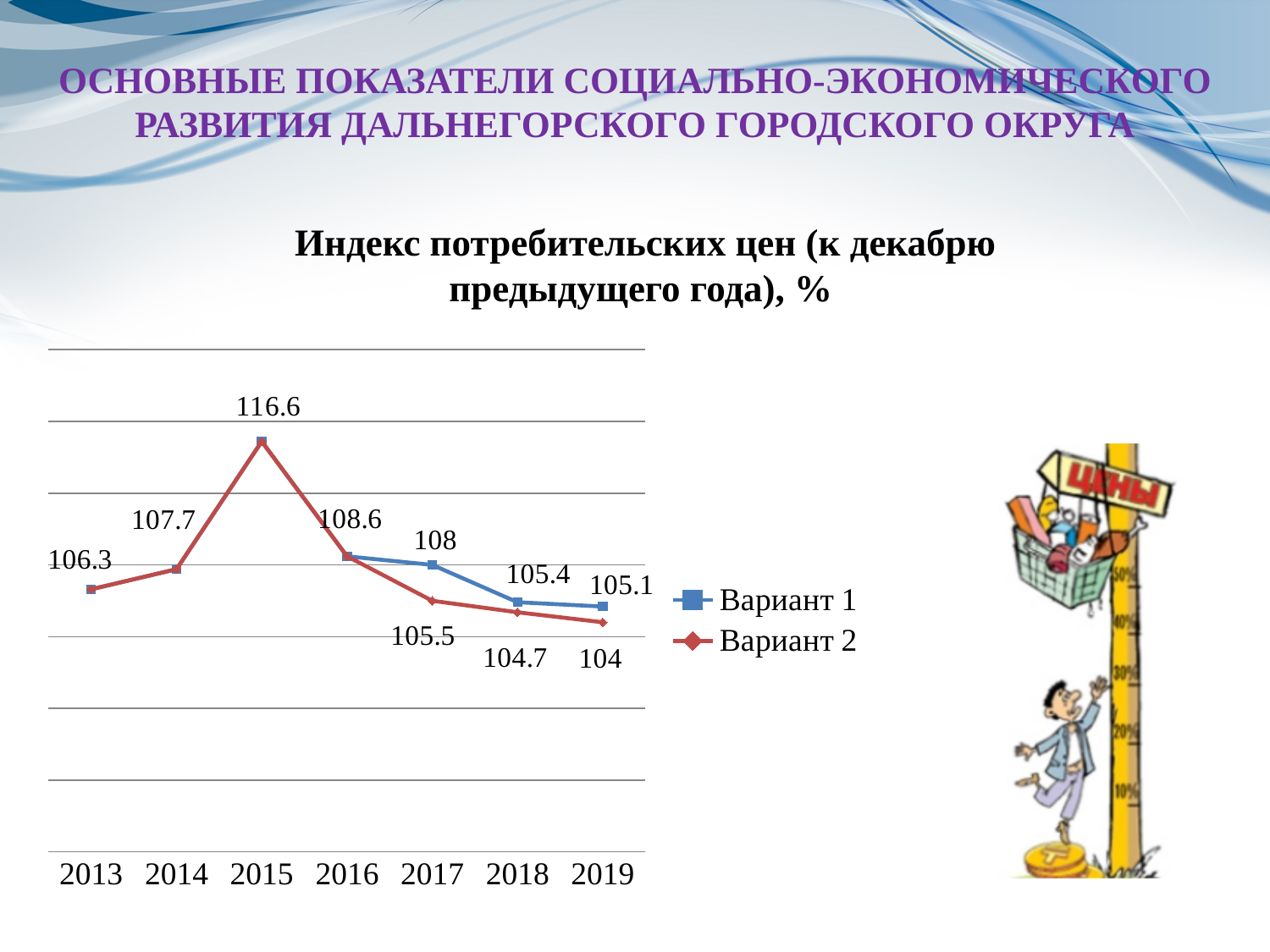
Which series has the lower value in 2019, Вариант 1 or Вариант 2? Вариант 2 What is the difference between Вариант 1 and Вариант 2 in 2017? 2.5 What is the value for Вариант 2 in 2018? 104.7 In which year is the consumer price index highest? 2015 What is the title of the chart? Индекс потребительских цен (к декабрю предыдущего года), % What is the value for Вариант 2 in 2019? 104 How many years are shown on the x axis? 7 How many series does the legend list? 2 What is the value for Вариант 1 in 2017? 108 What is the value of the consumer price index in 2015? 116.6 What type of chart is shown on the slide? Line chart Do the values rise or fall from 2015 to 2019? Fall